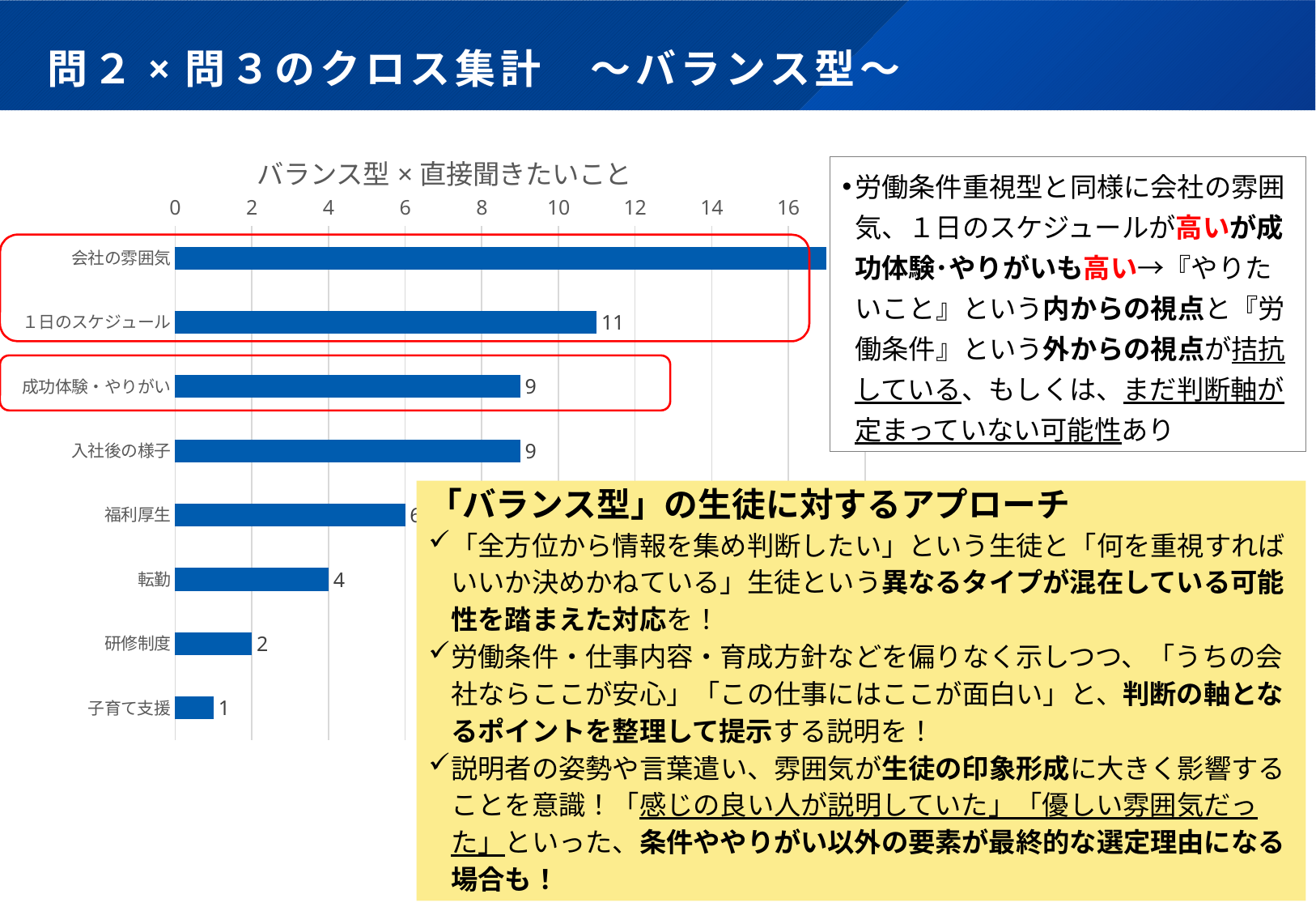
What is the value for 研修制度? 2 Which category has the lowest value in the chart? 子育て支援 What is the value for １日のスケジュール? 11 What kind of chart is shown on the slide? bar chart Which has a larger value, 転勤 or 研修制度? 転勤 What is the value for 子育て支援? 1 Which category has the highest value in the chart? 会社の雰囲気 What is the title of the chart? バランス型 × 直接聞きたいこと What is the difference between the values for １日のスケジュール and 成功体験・やりがい? 2 What is the value for 転勤? 4 How many categories are plotted in the chart? 8 Is the value for 会社の雰囲気 greater or less than 16? greater